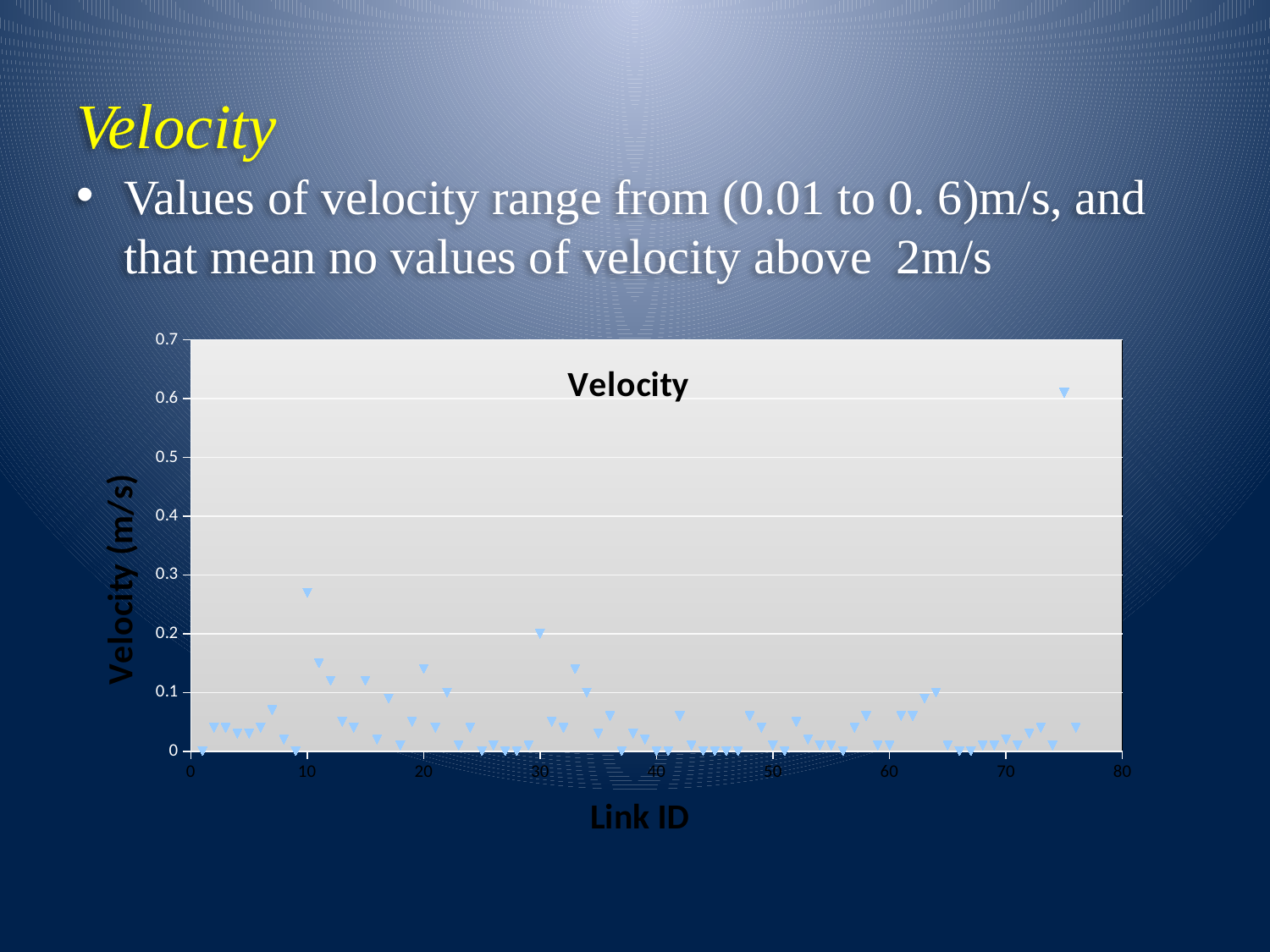
What kind of chart is shown on the slide? scatter chart Is the highest plotted velocity value greater or less than 0.7? less Is the highest plotted velocity value greater or less than 0.5? greater Is the velocity value plotted at Link ID 30 greater or less than 0.3? less What is the label of the y axis of the chart? Velocity (m/s) What is the title of the chart? Velocity Between which two x-axis ticks does the highest plotted point lie? 70 and 80 Which is higher: the velocity plotted at Link ID 10 or the velocity plotted at Link ID 30? Link ID 10